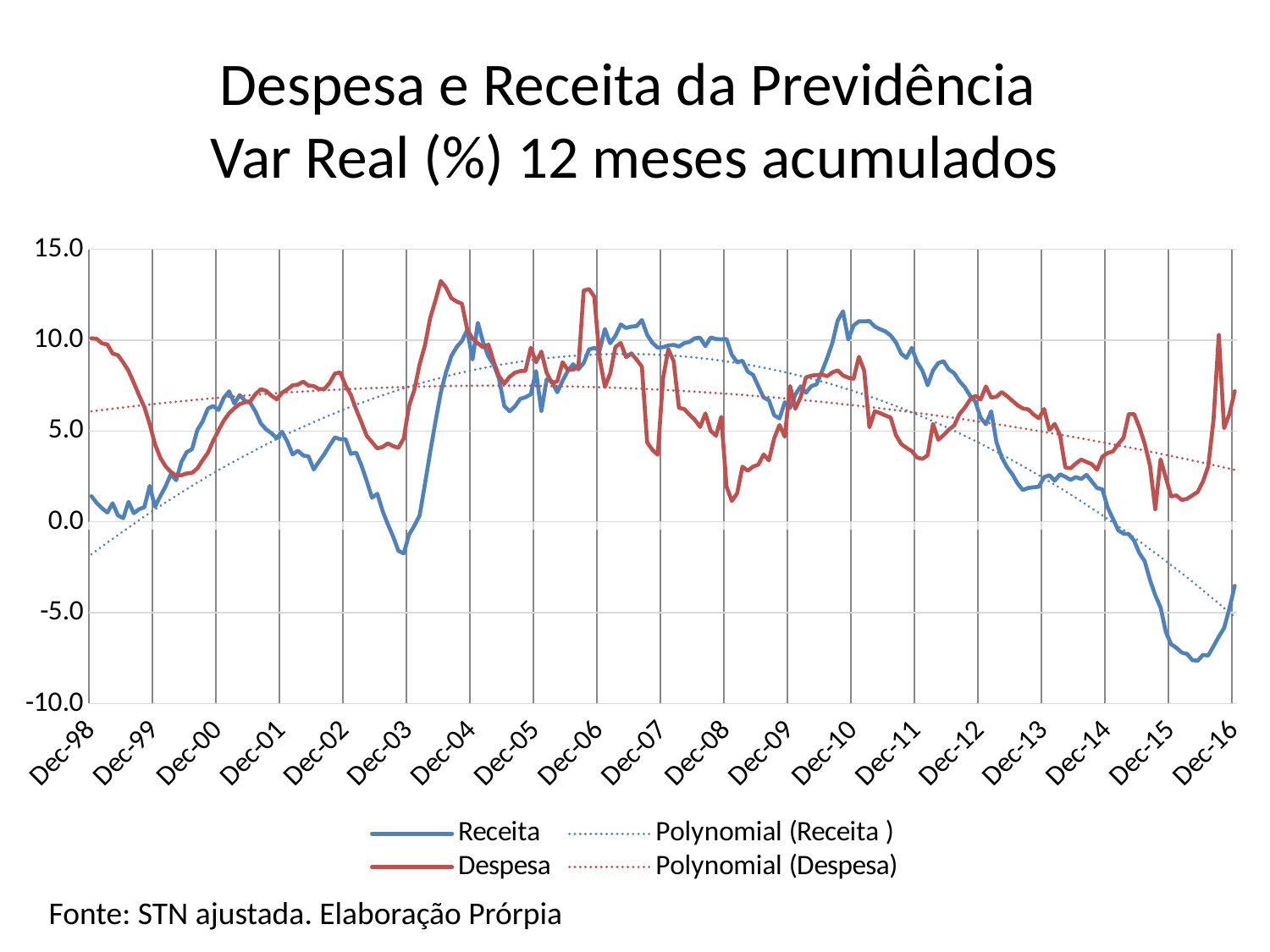
Is the value of Despesa at Dec-08 greater or less than 5.0? less How many date labels are shown on the x axis? 19 What is the source cited below the chart? STN ajustada. Elaboração Prórpia At Dec-15, which series has the larger value, Receita or Despesa? Despesa What kind of chart is shown on the slide? line chart Is the value of Receita at Dec-15 greater or less than -5.0? less Does the Receita line rise or fall between Dec-12 and Dec-15? fall Is the value of Receita at Dec-10 greater or less than 10.0? greater How many entries does the legend list? 4 At Dec-10, which series has the larger value, Receita or Despesa? Receita What colour is the Despesa line? red